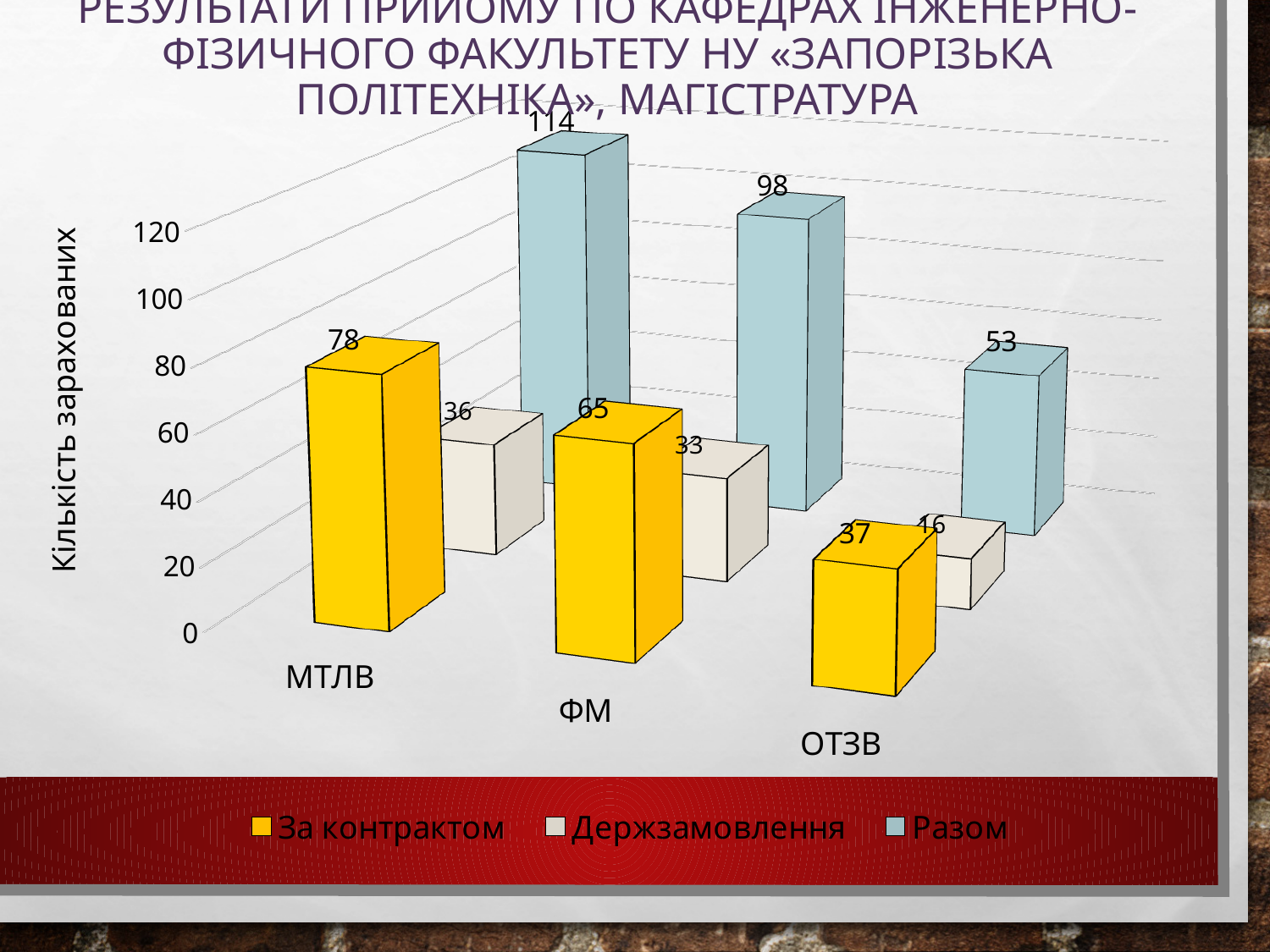
What kind of chart is shown on the slide? Bar chart How many series does the legend list? 3 Which category has the lowest value for За контрактом? ОТЗВ What is the value for За контрактом for МТЛВ? 78 What is the difference between the Разом values for МТЛВ and ОТЗВ? 61 What is the label of the vertical axis? Кількість зарахованих How many categories are shown on the x axis? 3 What is the value for Держзамовлення for ОТЗВ? 16 What is the value for Держзамовлення for ФМ? 33 Which category has the highest value for Разом? МТЛВ What is the value for Разом for ФМ? 98 Which is larger: За контрактом for ФМ or Держзамовлення for МТЛВ? За контрактом for ФМ